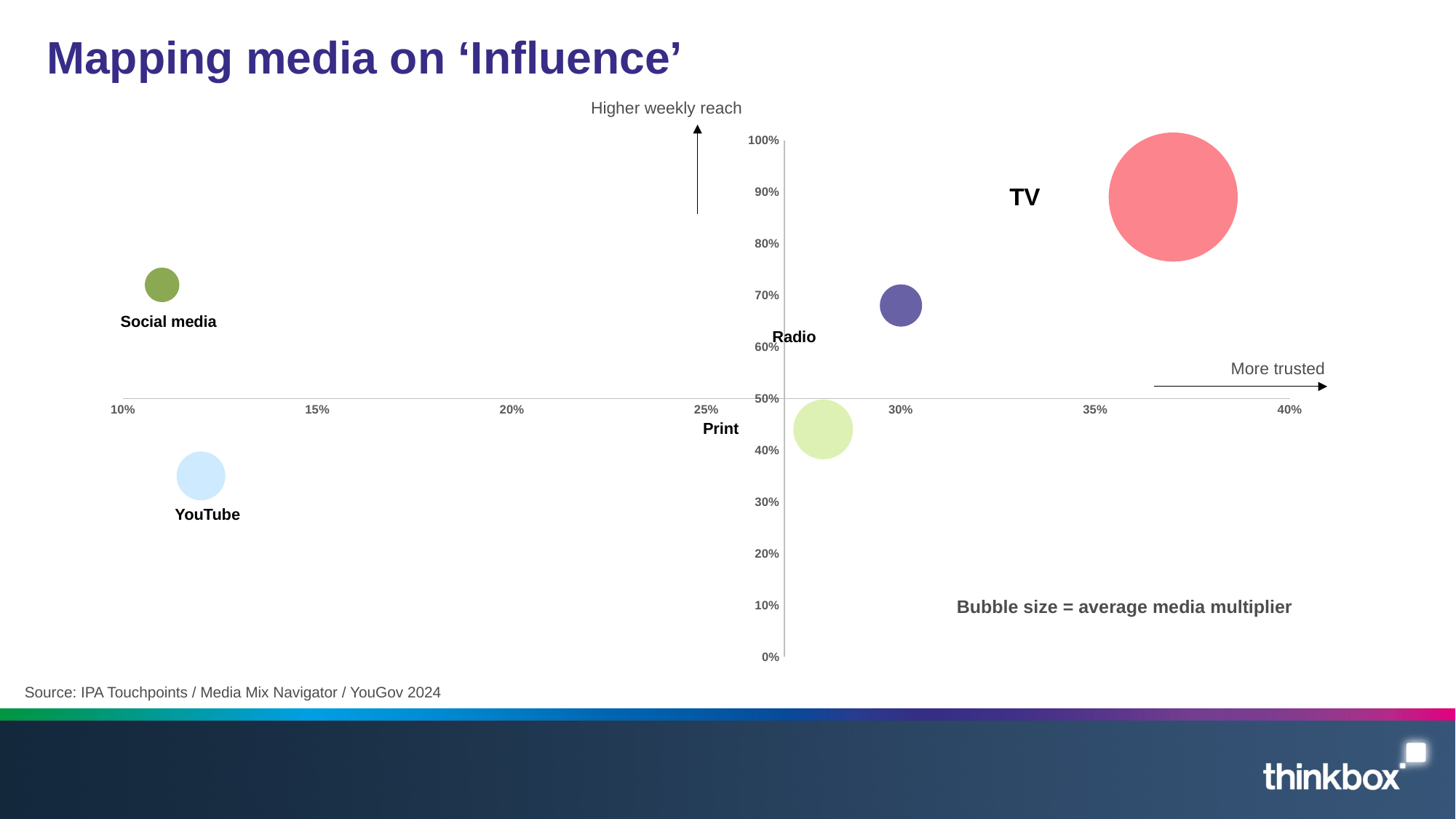
Is the weekly reach for Social media greater or less than 60%? greater How many media bubbles are plotted on the chart? 5 Which medium has the highest weekly reach on the chart? TV Which has the higher weekly reach, TV or Radio? TV Which has the higher weekly reach, Social media or YouTube? Social media Is the trust value for TV greater or less than 35%? greater Which medium is plotted as the least trusted (furthest left)? Social media Is the weekly reach for YouTube greater or less than 50%? less Which medium is plotted as the most trusted (furthest right)? TV Which medium has the lowest weekly reach on the chart? YouTube According to the note on the chart, what does bubble size represent? Average media multiplier What kind of chart is shown on the slide? Bubble chart